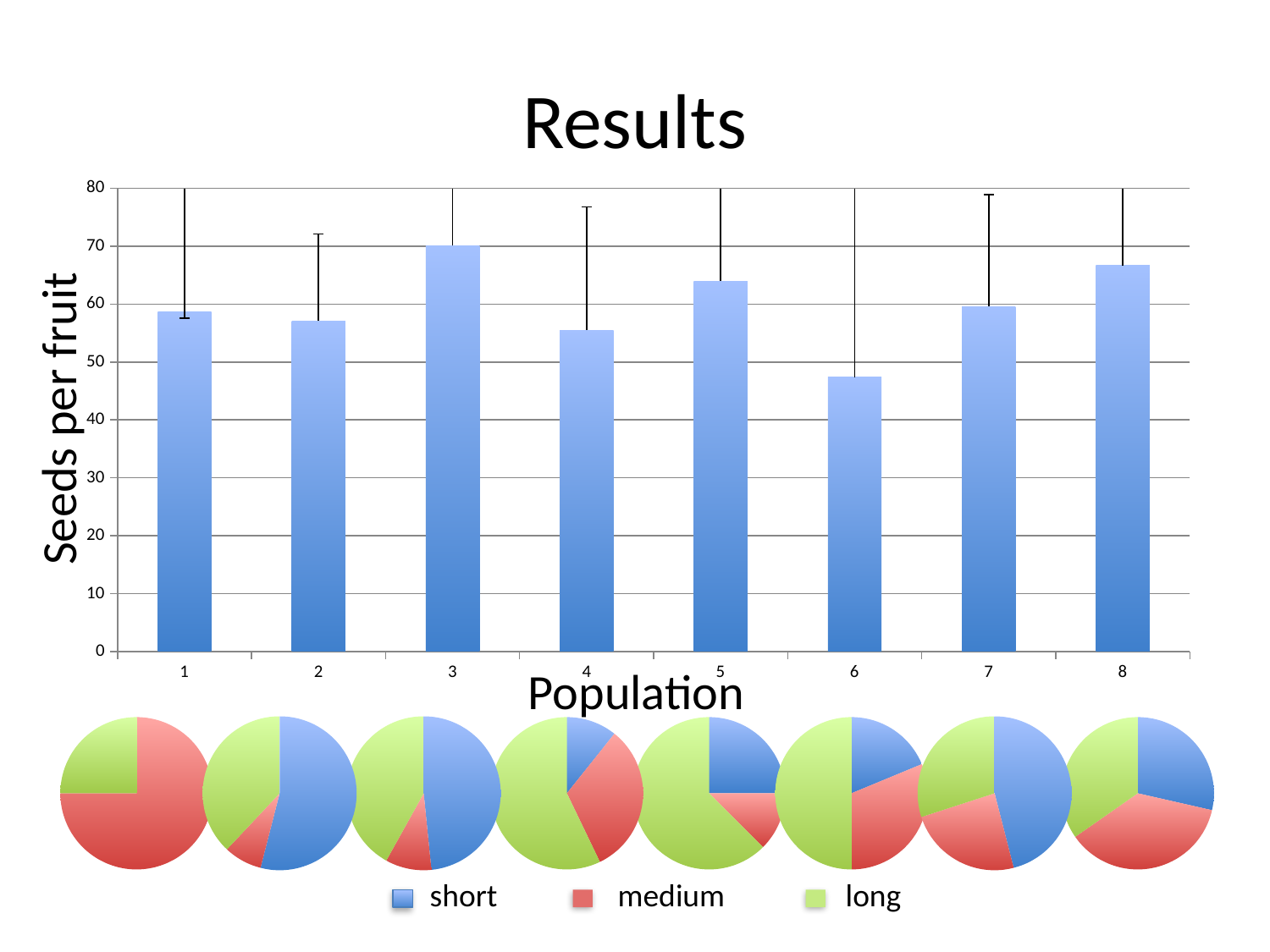
In the bar chart of seeds per fruit, is the value for population 5 greater or less than 60? greater What is the y-axis title of the bar chart? Seeds per fruit In the bar chart of seeds per fruit, which population has the highest value? 3 In the bar chart of seeds per fruit, how many populations are shown on the x axis? 8 How many pie charts are shown at the bottom of the slide? 8 How many categories does the legend below the pie charts list? 3 In the bar chart of seeds per fruit, which has the larger value, population 5 or population 2? population 5 In the bar chart of seeds per fruit, is the value for population 4 greater or less than 60? less What kind of chart is the upper chart showing seeds per fruit? bar chart In the bar chart of seeds per fruit, is the value for population 6 greater or less than 50? less In the bar chart of seeds per fruit, which population has the lowest value? 6